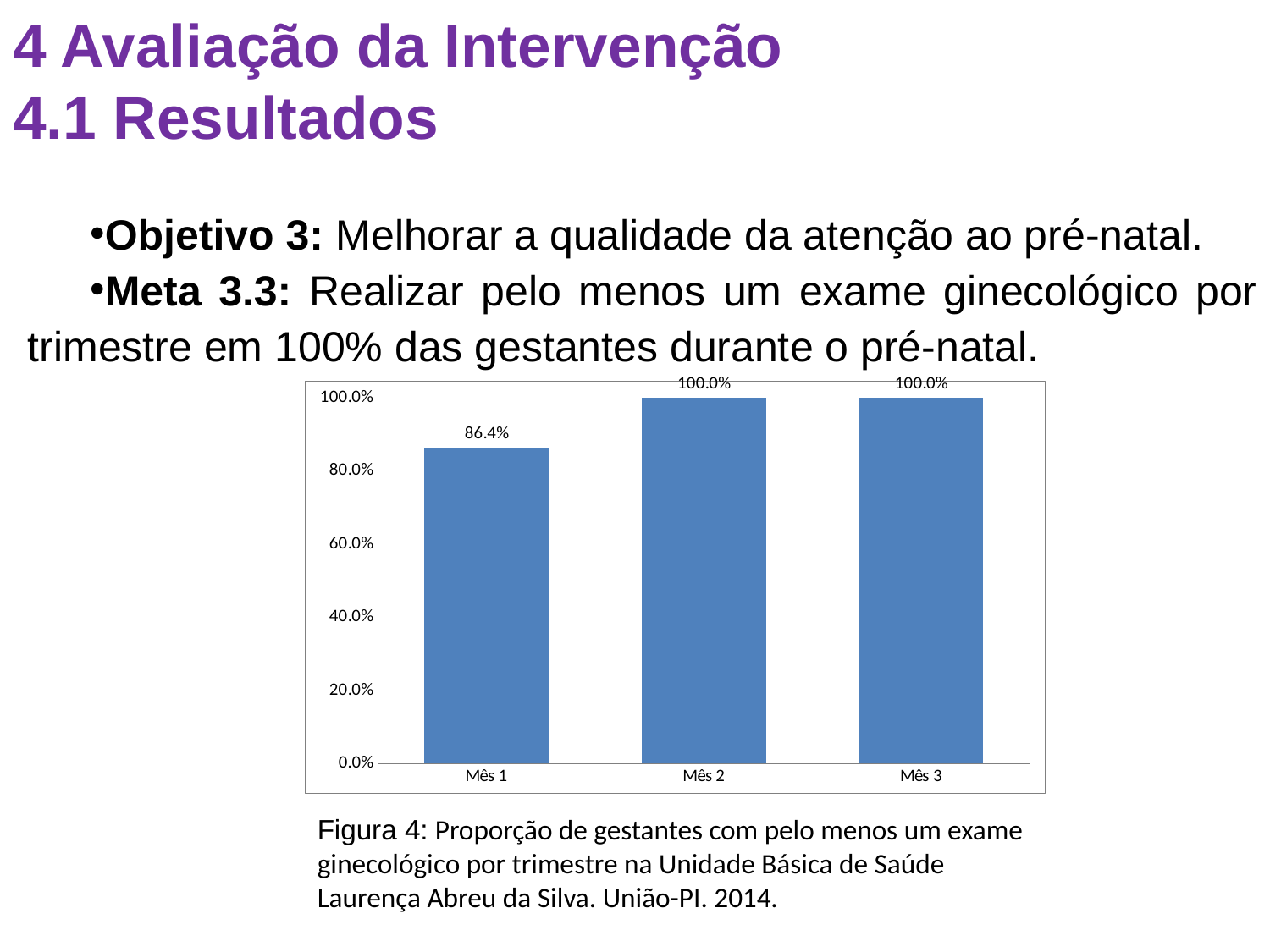
What is the value for Mês 1? 86.4% Is the value for Mês 1 greater or less than 80.0%? greater How many categories are shown on the x axis? 3 Do the values rise or fall from Mês 1 to Mês 3? rise What is the difference between the values for Mês 2 and Mês 1? 13.6% What figure number is given in the caption below the chart? Figura 4 Which is larger, the value for Mês 1 or the value for Mês 3? Mês 3 What kind of chart is shown on the slide? bar chart What is the value for Mês 3? 100.0% What is the value for Mês 2? 100.0% What is the highest value shown on the y axis? 100.0% Which month has the lowest value? Mês 1